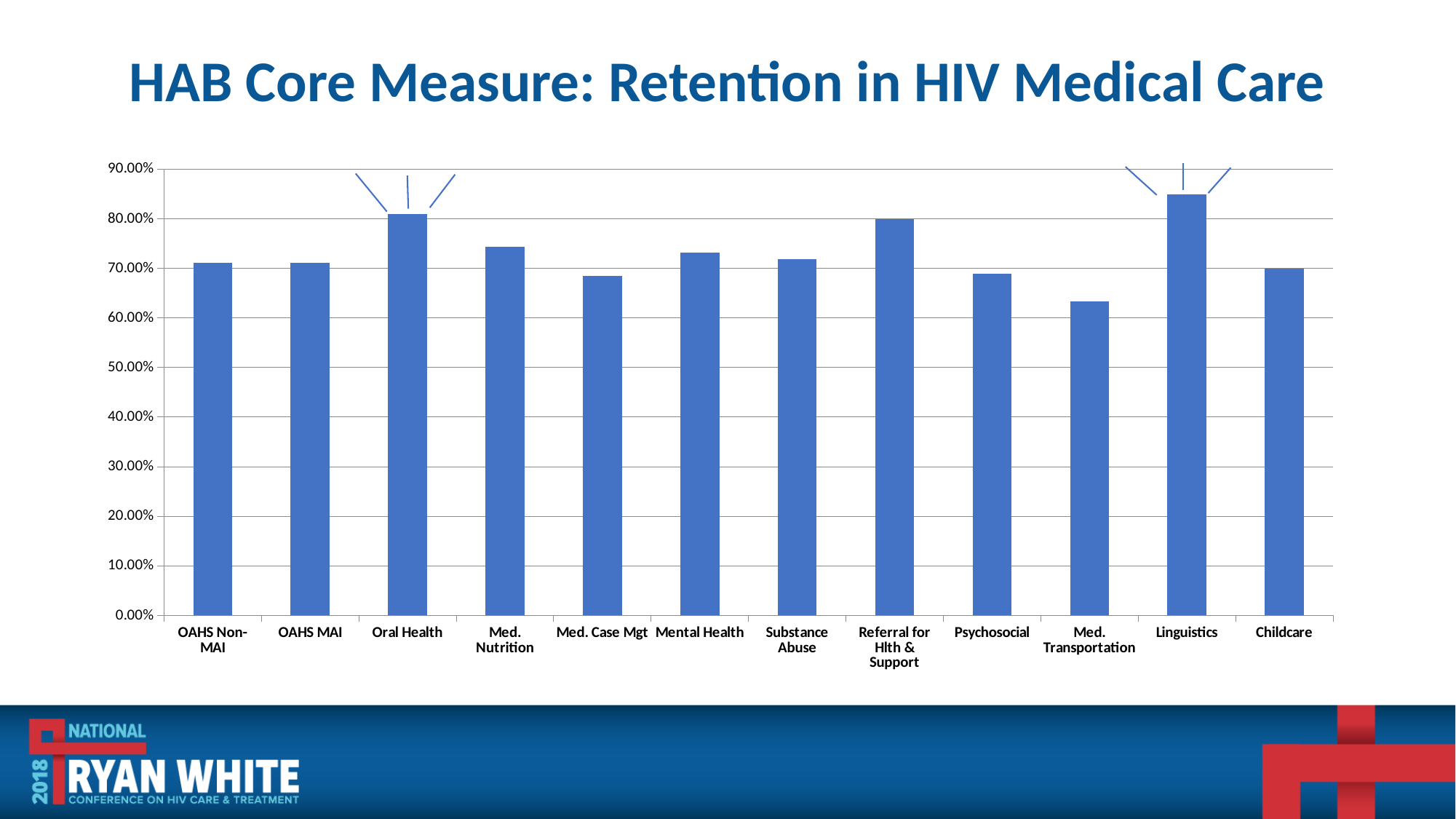
Is the value for Linguistics greater or less than 80.00%? greater What is the title of the slide? HAB Core Measure: Retention in HIV Medical Care Which is larger, the value for Mental Health or the value for Med. Transportation? Mental Health Is the value for Referral for Hlth & Support greater or less than 70.00%? greater Which category has the highest value? Linguistics Is the value for Oral Health greater or less than 70.00%? greater Which category has the lowest value? Med. Transportation Which is larger, the value for Oral Health or the value for Med. Case Mgt? Oral Health What kind of chart is shown on the slide? Bar chart How many categories are shown on the x axis of the chart? 12